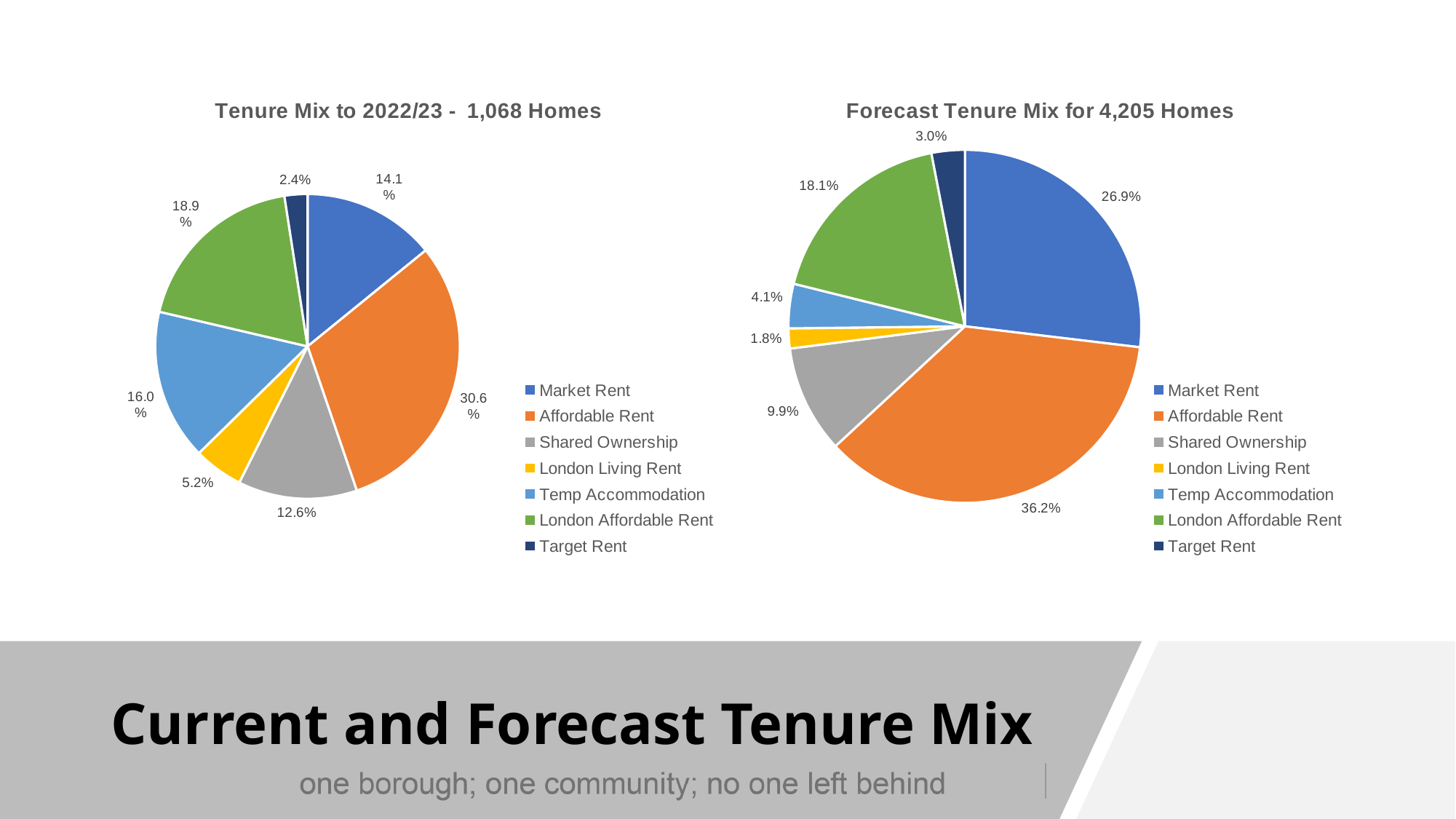
In the 'Forecast Tenure Mix for 4,205 Homes' chart, which tenure has the largest share? Affordable Rent What kind of chart is the 'Tenure Mix to 2022/23 - 1,068 Homes' chart? Pie chart In the 'Tenure Mix to 2022/23 - 1,068 Homes' chart, which is larger: London Affordable Rent or Shared Ownership? London Affordable Rent In the 'Forecast Tenure Mix for 4,205 Homes' chart, what share does Market Rent have? 26.9% In the 'Tenure Mix to 2022/23 - 1,068 Homes' chart, what share does Temp Accommodation have? 16.0% In the 'Forecast Tenure Mix for 4,205 Homes' chart, what share does London Living Rent have? 1.8% In the 'Forecast Tenure Mix for 4,205 Homes' chart, what colour is the Shared Ownership slice? Grey In the 'Tenure Mix to 2022/23 - 1,068 Homes' chart, what share does Affordable Rent have? 30.6% In the 'Tenure Mix to 2022/23 - 1,068 Homes' chart, which tenure has the smallest share? Target Rent How many tenure categories does the legend of the 'Forecast Tenure Mix for 4,205 Homes' chart list? 7 What is the difference between the Market Rent share in the 'Forecast Tenure Mix for 4,205 Homes' chart and the Market Rent share in the 'Tenure Mix to 2022/23 - 1,068 Homes' chart? 12.8% In the 'Forecast Tenure Mix for 4,205 Homes' chart, which tenure has the smallest share? London Living Rent